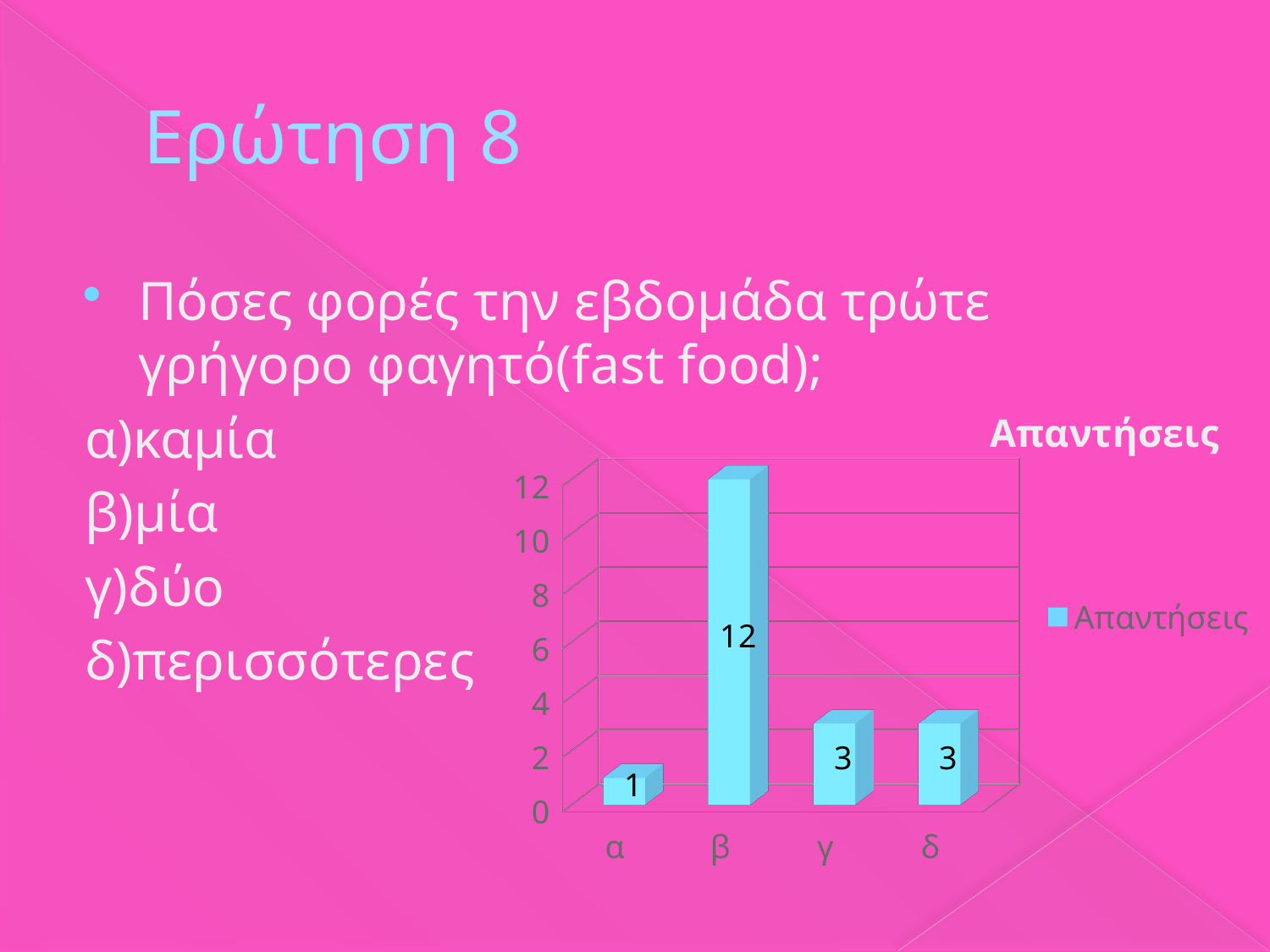
Is the value for β greater or less than 10? greater What is the difference between the values for β and γ? 9 What is the value for category δ? 3 What is the value for category β? 12 Which is larger, the value for α or the value for δ? δ How many categories are shown on the x axis? 4 What is the value for category α? 1 What is the title of the chart? Απαντήσεις What kind of chart is shown on the slide? bar chart Which category has the highest value? β What is the value for category γ? 3 Which category has the lowest value? α